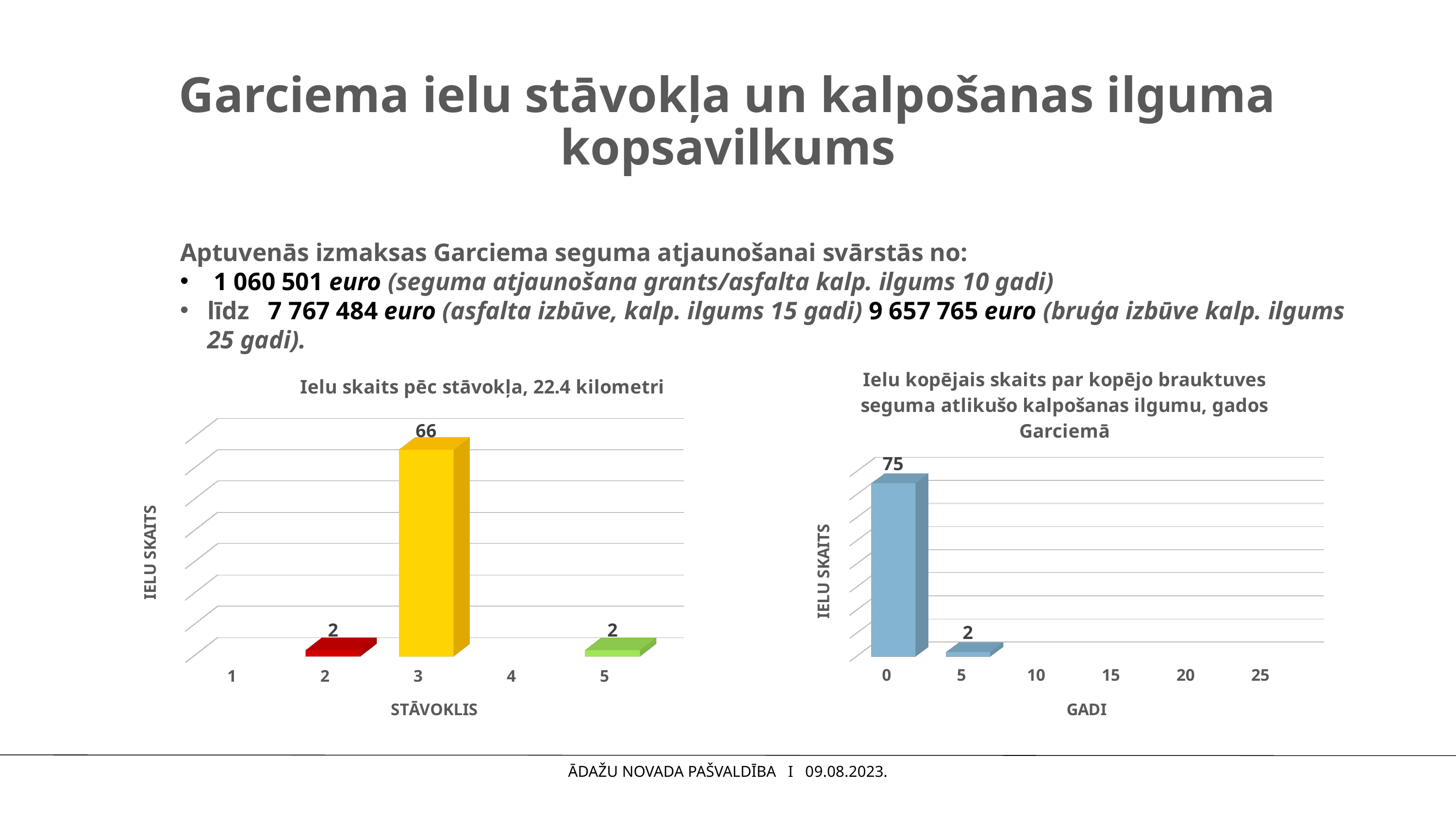
In the left chart 'Ielu skaits pēc stāvokļa, 22.4 kilometri', what is the value for condition (STĀVOKLIS) 3? 66 In the right chart 'Ielu kopējais skaits par kopējo brauktuves seguma atlikušo kalpošanas ilgumu, gados Garciemā', what is the difference between the values for 0 years and 5 years? 73 In the right chart 'Ielu kopējais skaits par kopējo brauktuves seguma atlikušo kalpošanas ilgumu, gados Garciemā', what is the value for 0 years (GADI)? 75 In the left chart 'Ielu skaits pēc stāvokļa, 22.4 kilometri', how many categories are shown on the x axis? 5 In the left chart 'Ielu skaits pēc stāvokļa, 22.4 kilometri', what is the value for condition 2? 2 In the right chart 'Ielu kopējais skaits par kopējo brauktuves seguma atlikušo kalpošanas ilgumu, gados Garciemā', which is larger: the value for 0 years or for 5 years? 0 years In the left chart 'Ielu skaits pēc stāvokļa, 22.4 kilometri', which condition category has the highest value? 3 In the left chart 'Ielu skaits pēc stāvokļa, 22.4 kilometri', what is the difference between the values for condition 3 and condition 5? 64 What type of chart is the left chart 'Ielu skaits pēc stāvokļa, 22.4 kilometri'? bar chart In the right chart 'Ielu kopējais skaits par kopējo brauktuves seguma atlikušo kalpošanas ilgumu, gados Garciemā', how many categories are shown on the x axis? 6 What is the x-axis title of the right chart 'Ielu kopējais skaits par kopējo brauktuves seguma atlikušo kalpošanas ilgumu, gados Garciemā'? GADI In the right chart 'Ielu kopējais skaits par kopējo brauktuves seguma atlikušo kalpošanas ilgumu, gados Garciemā', what is the value for 5 years? 2